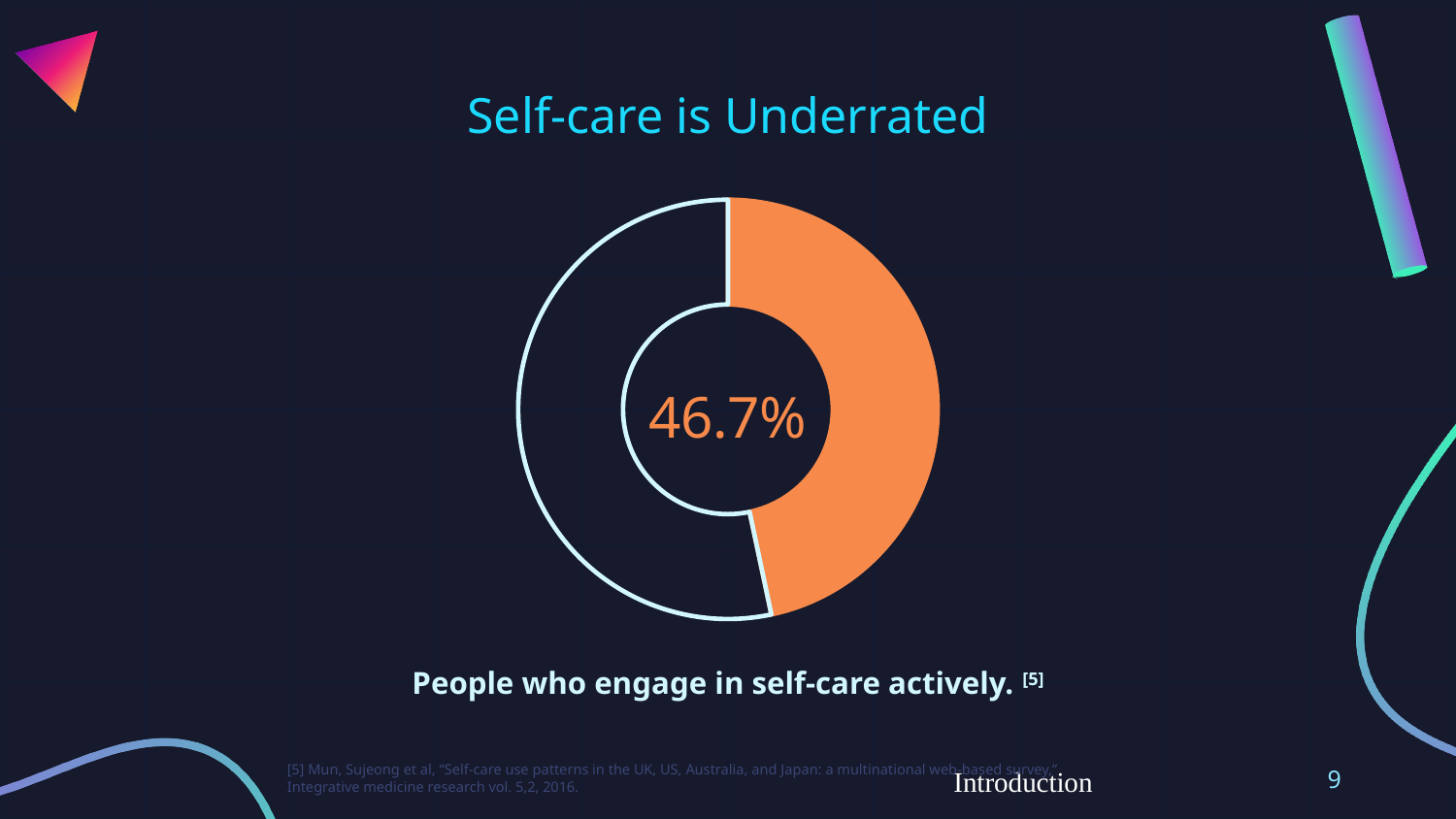
How many segments does the donut chart have? 2 What kind of chart is shown on the slide? donut chart Which segment of the chart is larger, the orange segment or the dark segment? the dark segment What share of the chart does the dark (non-orange) segment represent? 53.3% What percentage is printed in the centre of the chart? 46.7% Is the share of people who engage in self-care actively greater or less than 50%? less What is the title of the slide containing the chart? Self-care is Underrated What share of the chart does the orange segment represent? 46.7% What does the caption below the chart say the highlighted value represents? People who engage in self-care actively.